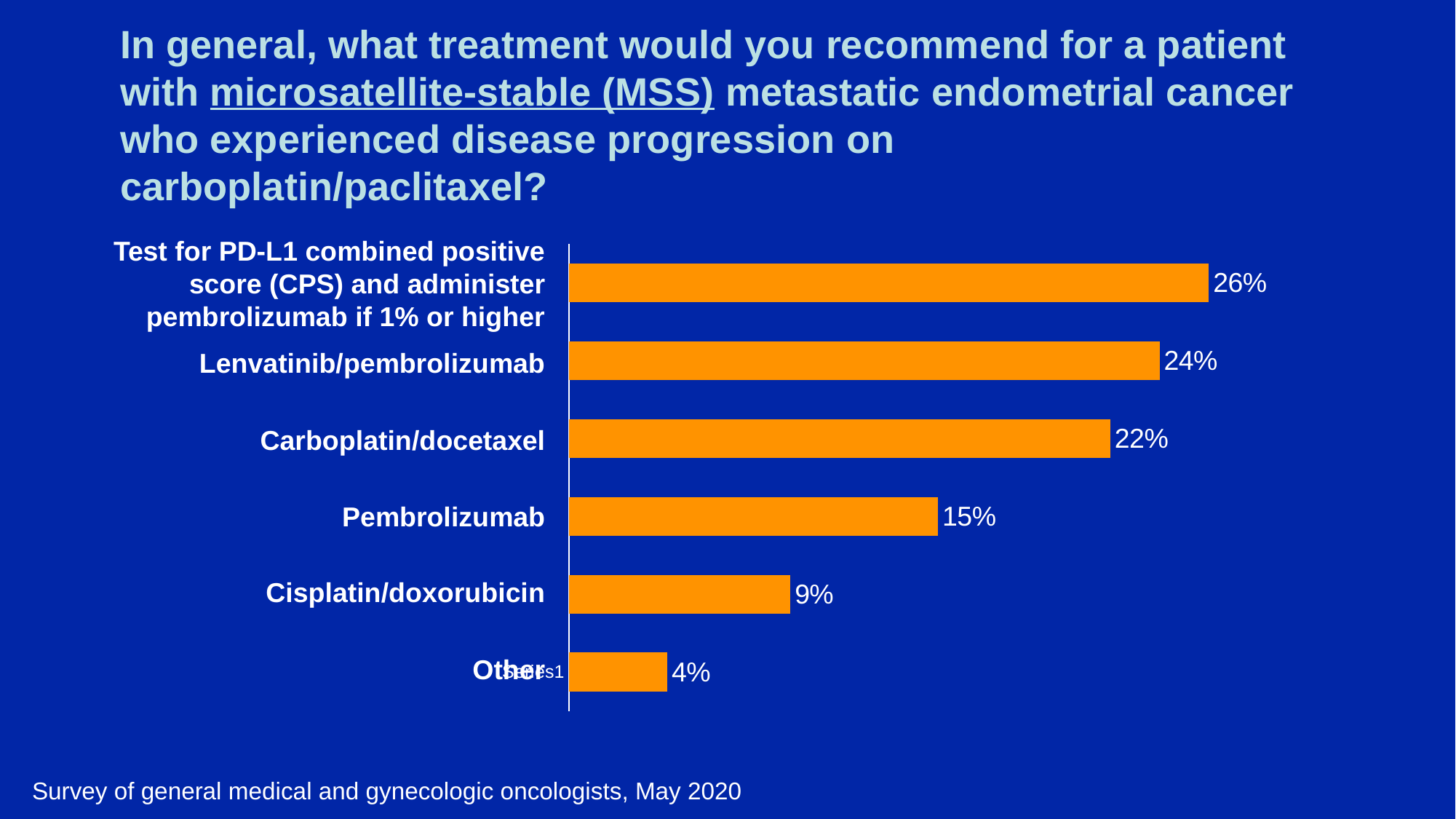
How many treatment categories are shown in the chart? 6 What is the difference between the percentages for Carboplatin/docetaxel and Cisplatin/doxorubicin? 13% What colour are the bars in the chart? Orange Which is larger, the value for Pembrolizumab or the value for Cisplatin/doxorubicin? Pembrolizumab What percentage is shown for Pembrolizumab alone? 15% Which category has the lowest percentage? Other What is the value for Cisplatin/doxorubicin? 9% Which treatment option has the highest percentage? Test for PD-L1 combined positive score (CPS) and administer pembrolizumab if 1% or higher What percentage of respondents recommended Lenvatinib/pembrolizumab? 24% What is the difference between the top two categories, the PD-L1 CPS testing option and Lenvatinib/pembrolizumab? 2% What type of chart is shown on the slide? Bar chart What is the value shown for Carboplatin/docetaxel? 22%